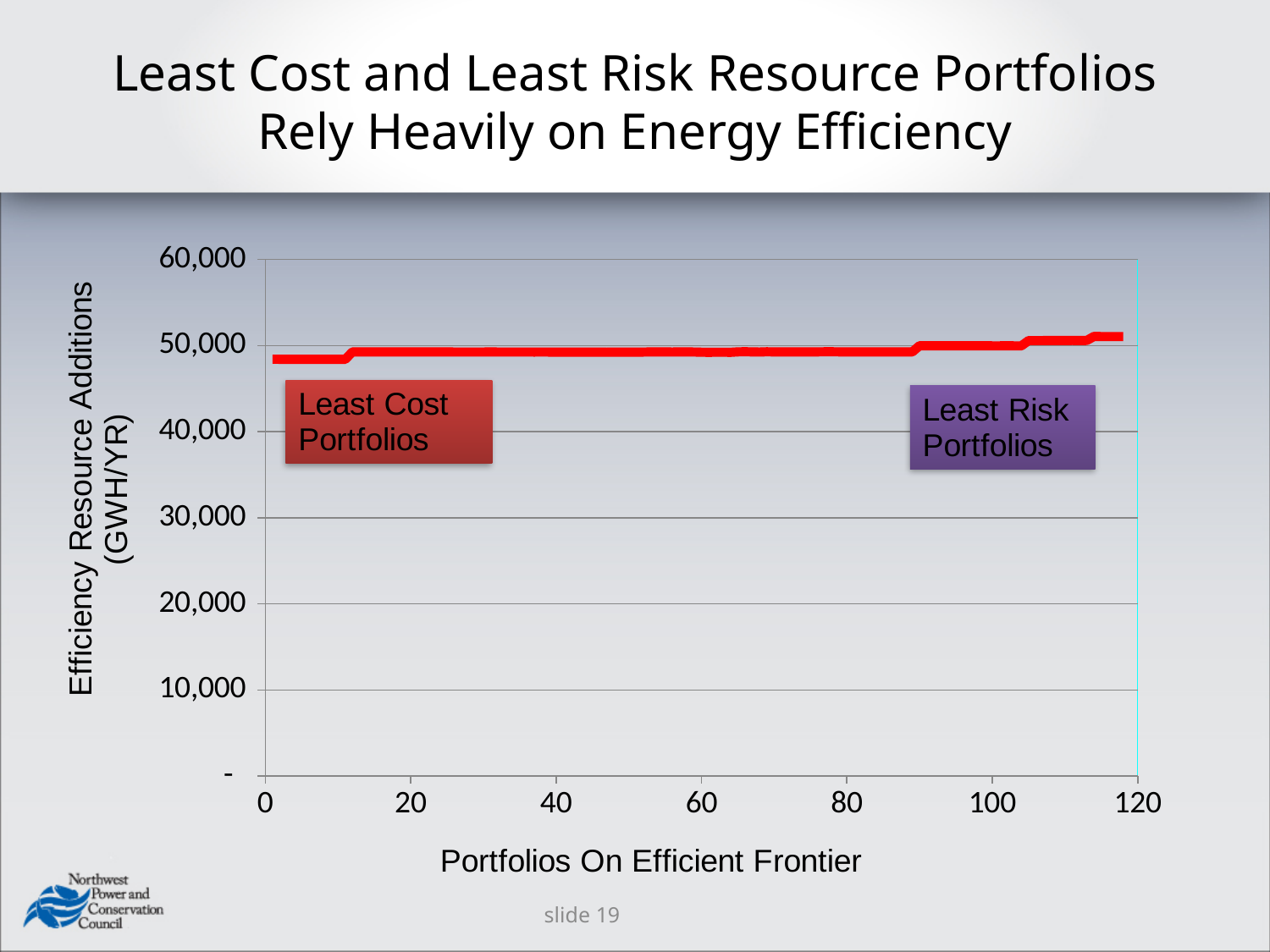
How many lines are plotted on the chart? 1 What is the highest value shown on the y axis? 60,000 What kind of chart is shown on the slide? line chart What is the title of the x axis? Portfolios On Efficient Frontier Is the value at portfolio 60 greater or less than 30,000? greater Do the values on the chart rise or fall as the portfolio number increases along the x axis? rise Is the value at portfolio 100 greater or less than 60,000? less Is the value at the right end of the line (around portfolio 115) higher or lower than at the left end (portfolio 0)? higher Is the value at portfolio 0 greater or less than 40,000? greater